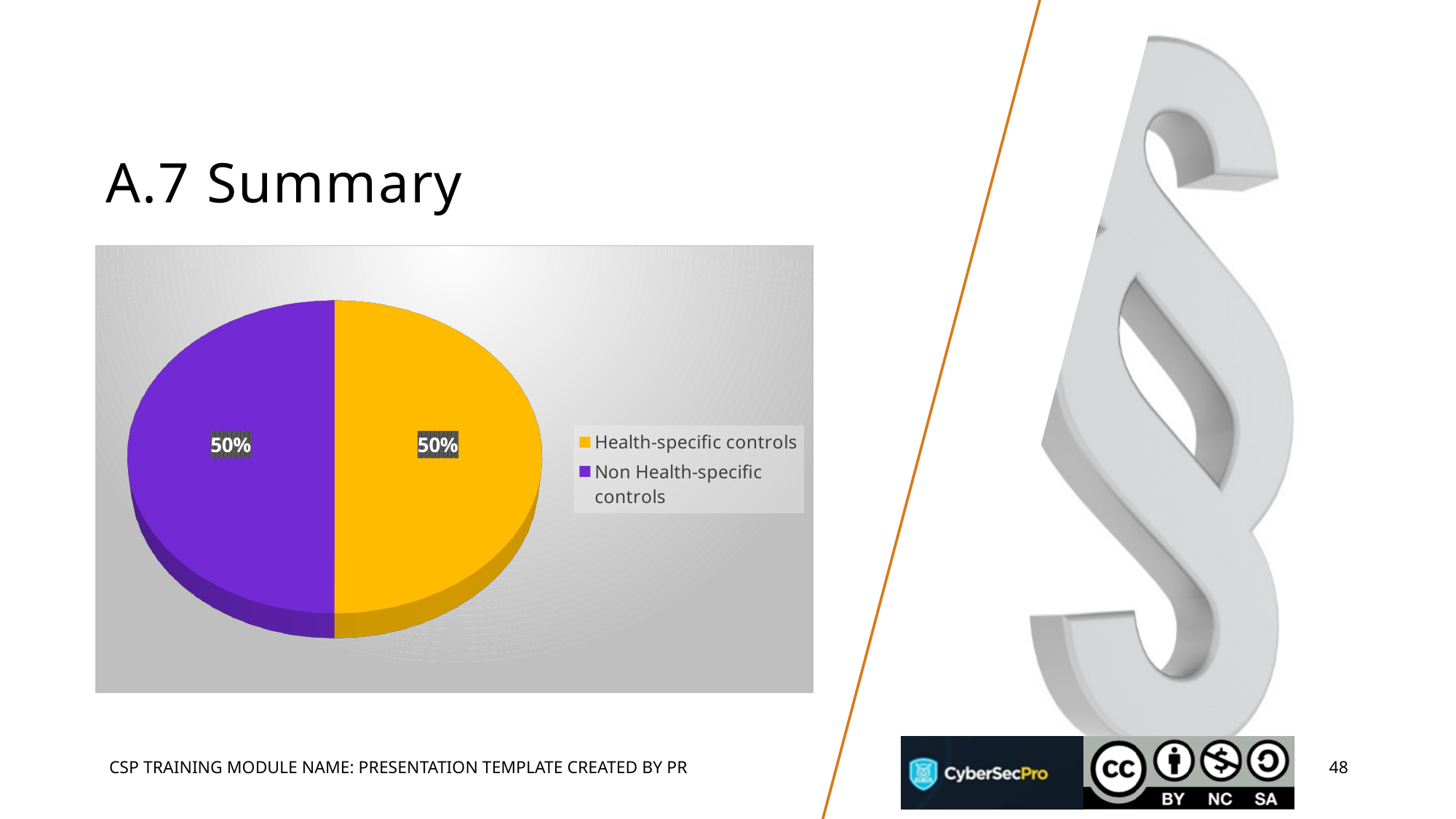
What is the difference between the shares of Health-specific controls and Non Health-specific controls? 0% What share of the pie is Non Health-specific controls? 50% Is the share for Health-specific controls greater or less than 40%? greater What share of the pie is Health-specific controls? 50% What kind of chart is shown on the slide? pie chart Which colour represents Non Health-specific controls in the pie chart? purple Is the share for Non Health-specific controls greater or less than 60%? less How many slices does the pie chart have? 2 How many entries does the legend list? 2 Which colour represents Health-specific controls in the pie chart? yellow